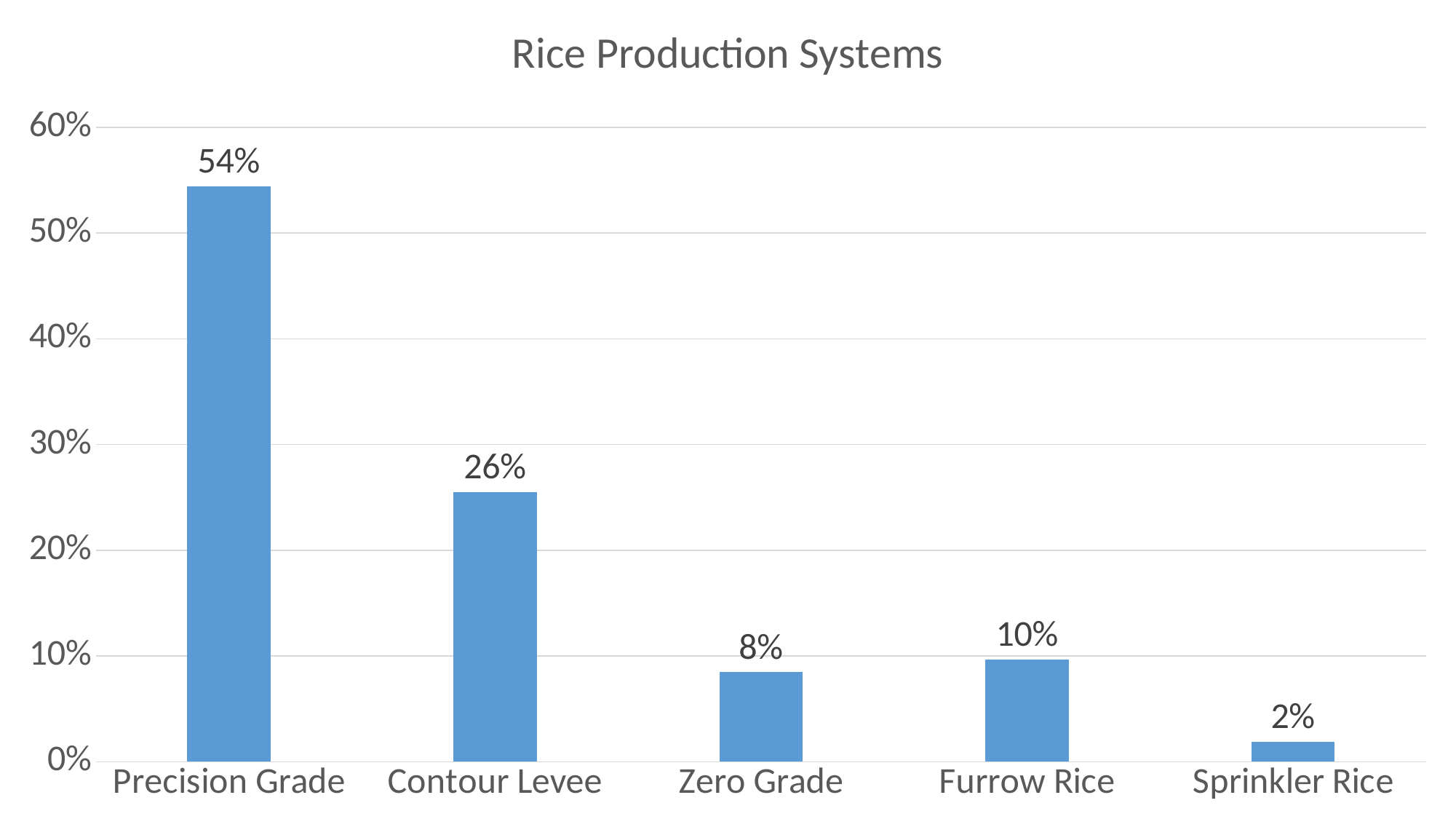
What is the value for Contour Levee? 26% Which is larger, the value for Furrow Rice or the value for Zero Grade? Furrow Rice What is the value for Zero Grade? 8% What is the difference between the values for Precision Grade and Contour Levee? 28% Which category has the lowest value? Sprinkler Rice Which category has the highest value? Precision Grade Is the value for Contour Levee greater or less than 30%? less What is the value for Sprinkler Rice? 2% What is the value for Precision Grade? 54% How many categories are shown on the x axis? 5 What kind of chart is this? bar chart What is the title of the chart? Rice Production Systems